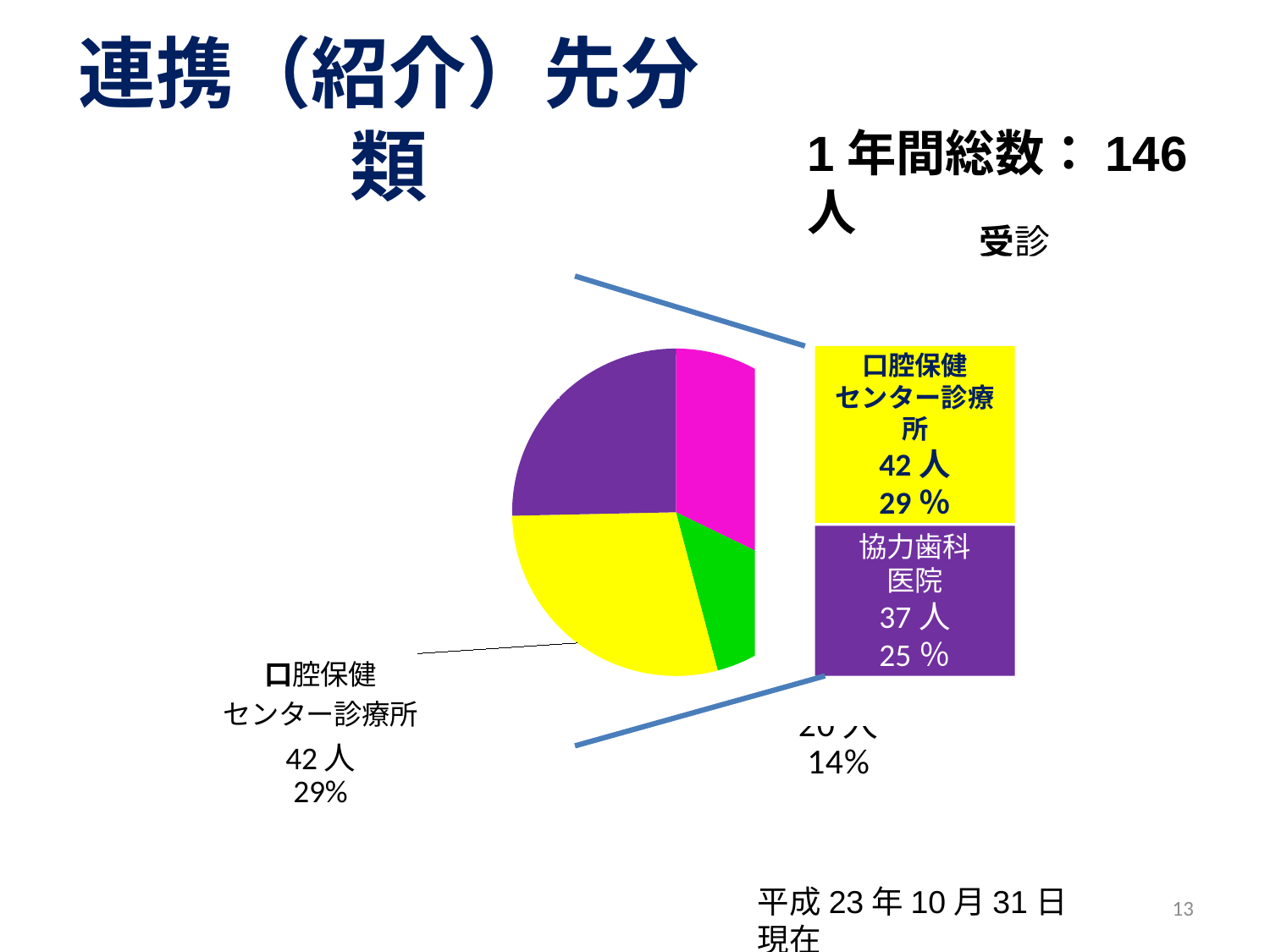
Which colour is the slice for 協力歯科医院? purple Which colour slice of the pie is the smallest? green What percentage of the pie does 口腔保健センター診療所 represent? 29% What is the difference in the number of people between 口腔保健センター診療所 and 協力歯科医院? 5人 What kind of chart is shown on the slide? pie chart What percentage of the pie does 協力歯科医院 represent? 25% How many people were referred to 協力歯科医院? 37人 How many people were referred to 口腔保健センター診療所? 42人 Which has more people, 口腔保健センター診療所 or 協力歯科医院? 口腔保健センター診療所 What is the total number of people for the year shown on the slide? 146人 How many slices does the pie chart have? 4 Which colour is the slice for 口腔保健センター診療所? yellow